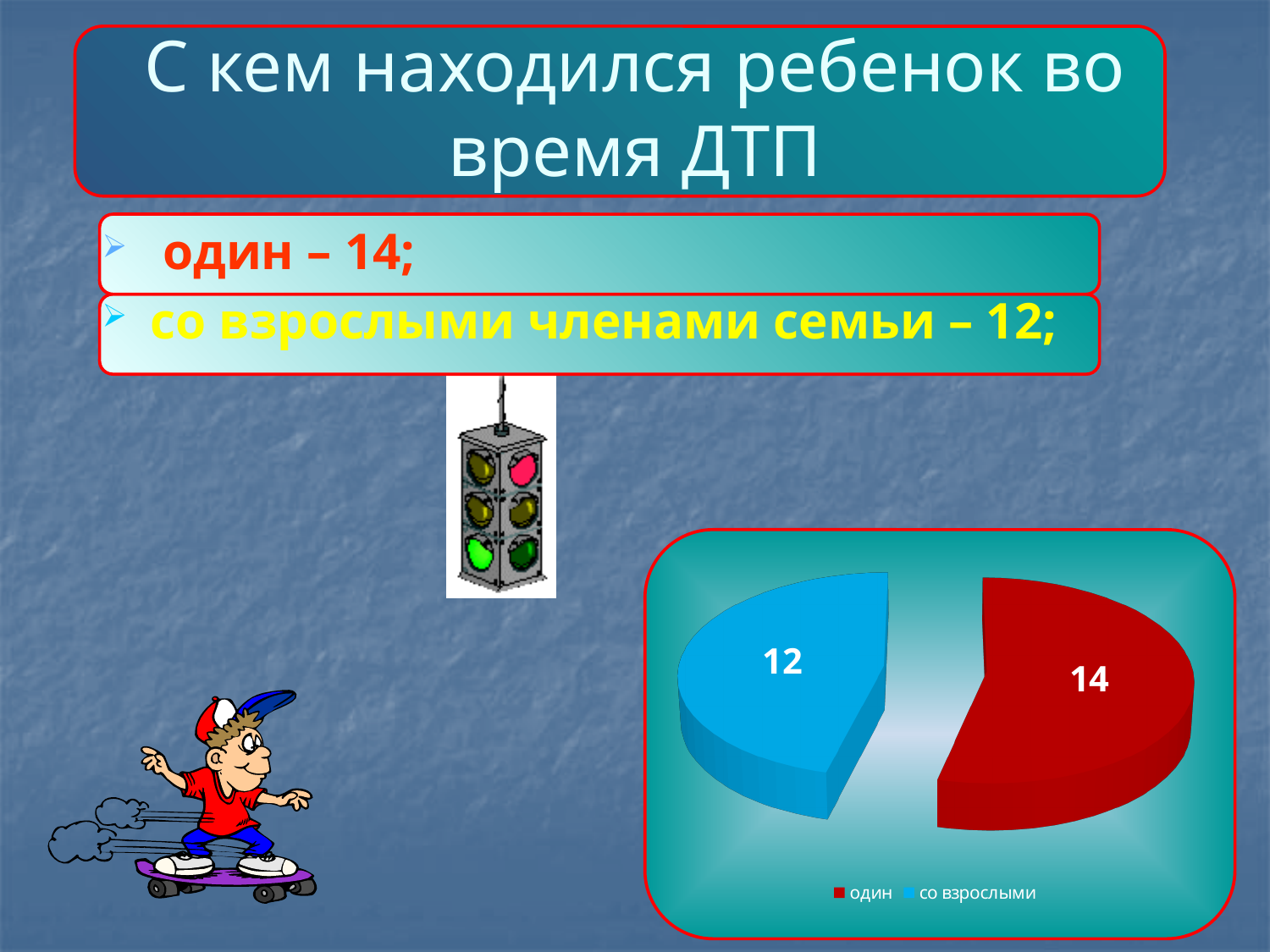
What is the value of the "один" slice in the pie chart? 14 How many entries does the pie chart legend list? 2 What colour is the "со взрослыми" slice in the pie chart? blue How many slices does the pie chart have? 2 Which slice of the pie chart is the largest? один What is the total of all slices in the pie chart? 26 What is the value of the "со взрослыми" slice in the pie chart? 12 What colour is the "один" slice in the pie chart? red What kind of chart is shown on the slide? pie chart What is the difference between the "один" and "со взрослыми" values in the pie chart? 2 Which slice of the pie chart is the smallest? со взрослыми Which is larger in the pie chart: "один" or "со взрослыми"? один